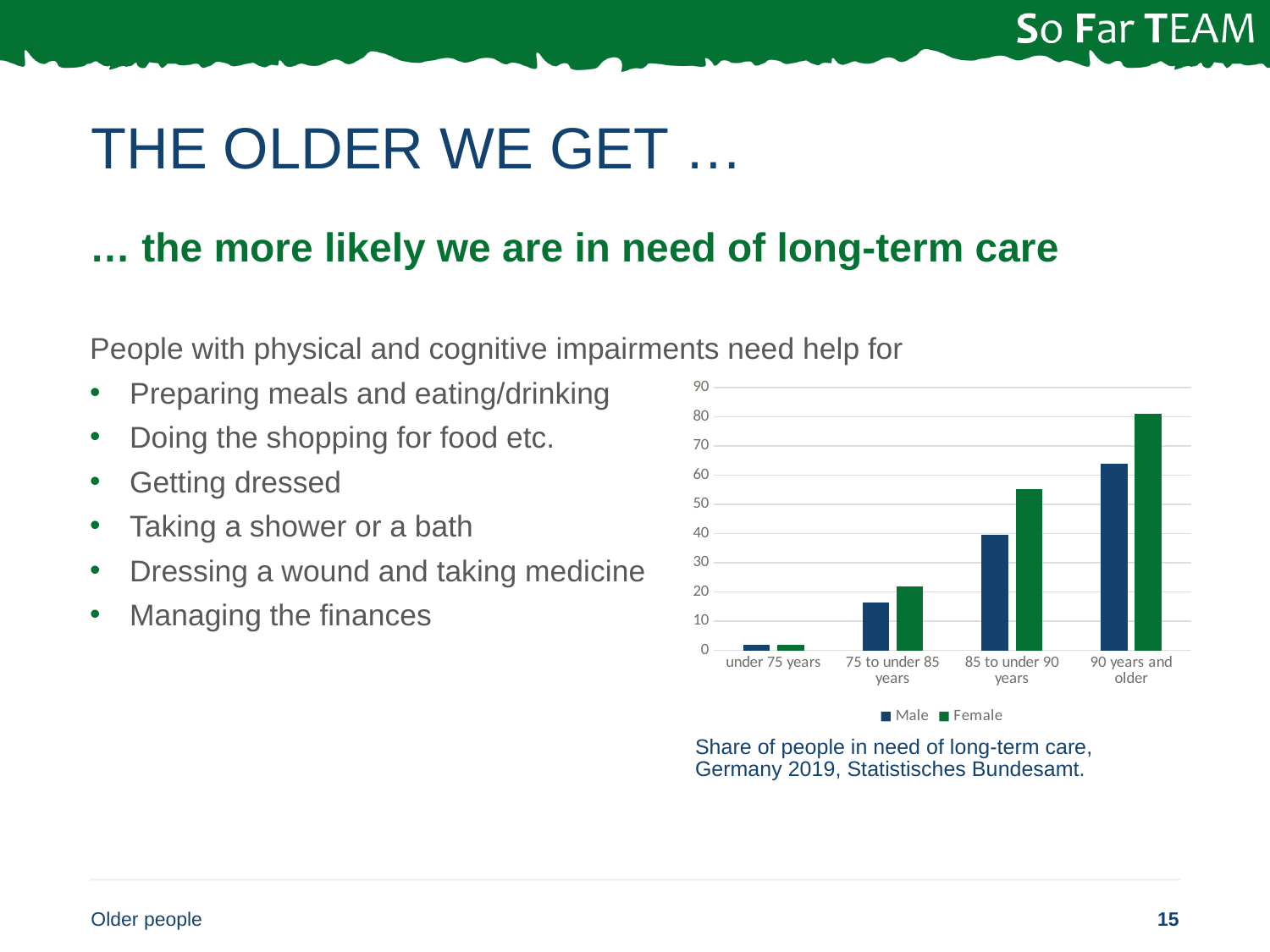
Is the Male value for 75 to under 85 years greater or less than 20? less Which series are listed in the chart's legend? Male and Female How many age categories are shown on the x axis of the chart? 4 What is the highest value shown on the chart's vertical axis? 90 How many series does the chart's legend list? 2 For the 85 to under 90 years category, which is larger, the Male or the Female value? Female Do the Female values rise or fall as the age categories increase along the x axis? rise What kind of chart is shown on the slide? bar chart Which age category has the highest Female value? 90 years and older Is the Female value for 90 years and older greater or less than 70? greater Which age category has the lowest Male value? under 75 years Is the Male value for 85 to under 90 years greater or less than 30? greater